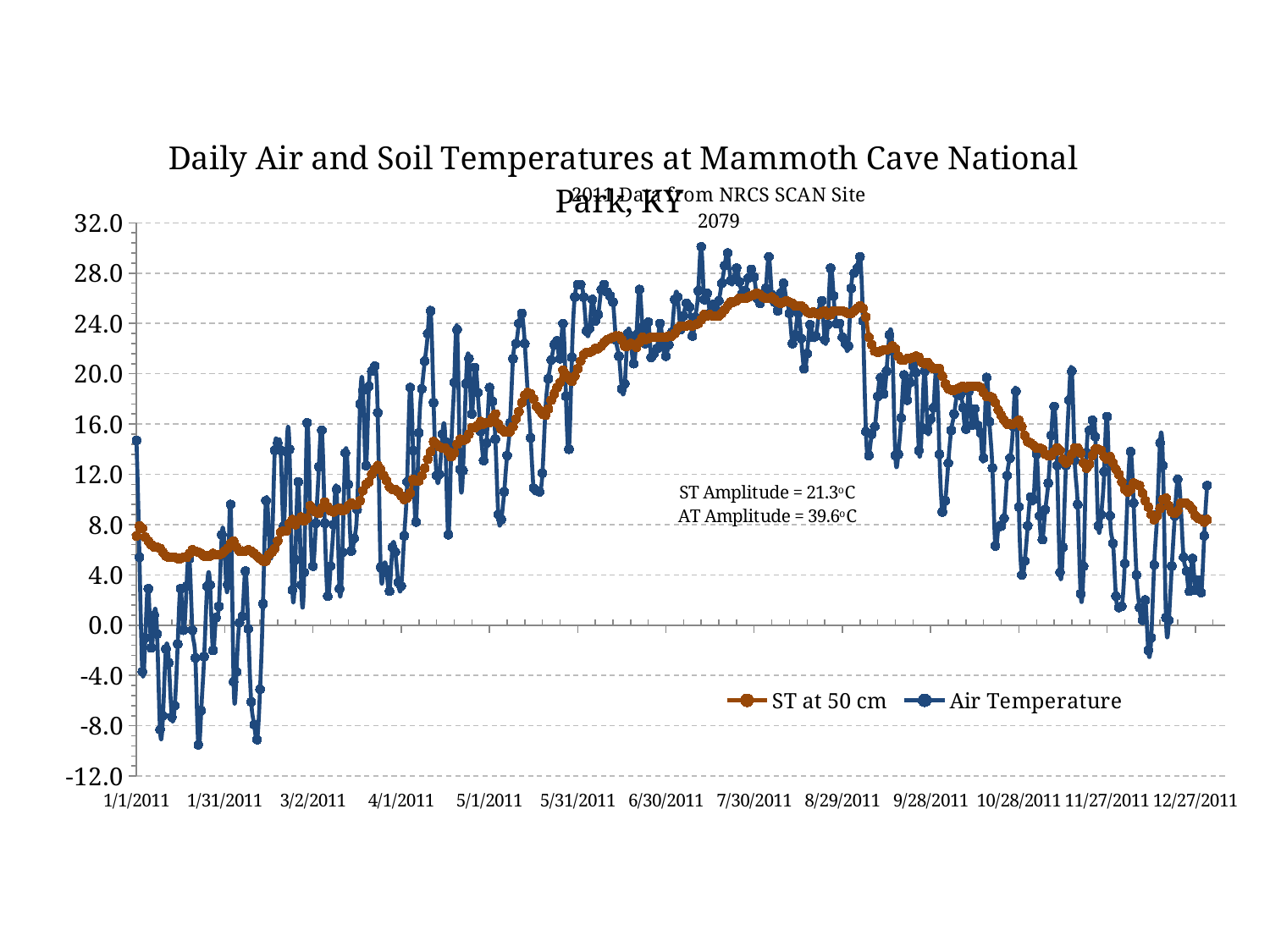
What kind of chart is shown on the slide? Line chart Which series reaches a higher peak value, ST at 50 cm or Air Temperature? Air Temperature Does the ST at 50 cm series rise or fall from 1/1/2011 to 7/30/2011? rise What is the ST Amplitude printed on the chart? 21.3°C What is the AT Amplitude printed on the chart? 39.6°C Is the highest ST at 50 cm value on the chart greater or less than 24.0? greater Is the lowest Air Temperature value on the chart greater or less than -8.0? less Which has the larger amplitude according to the annotation, ST or AT? AT What is the difference between the AT Amplitude and the ST Amplitude printed on the chart? 18.3°C Is the highest Air Temperature value on the chart greater or less than 28.0? greater How many series does the legend list? 2 What are the two series named in the legend? ST at 50 cm and Air Temperature